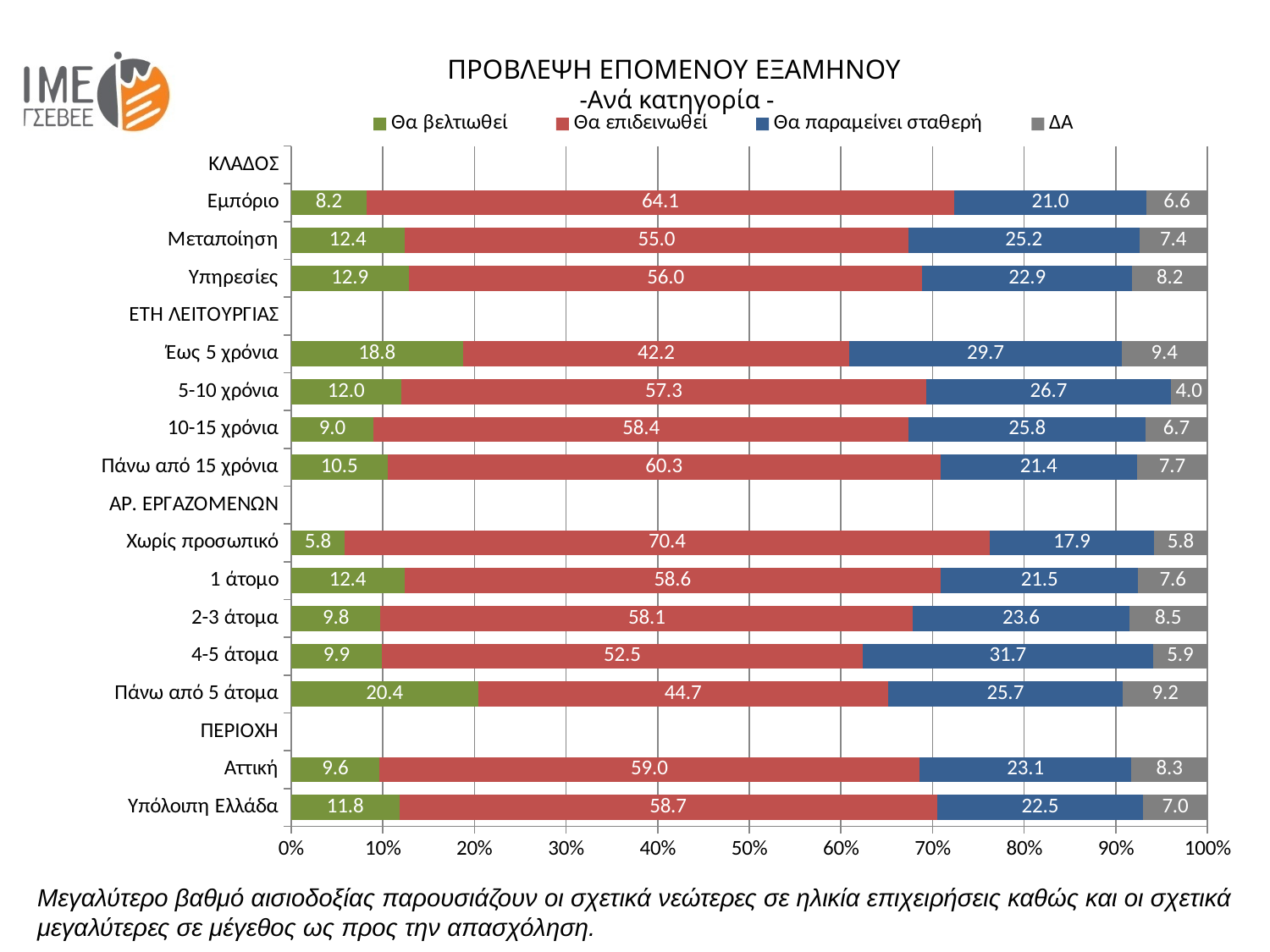
What type of chart is shown on the slide? Stacked bar chart What is the subtitle of the chart? -Ανά κατηγορία - What is the total of the stacked bar for Εμπόριο? 99.9 How many series does the legend list? 4 What is the value of 'Θα παραμείνει σταθερή' for 4-5 άτομα? 31.7 What is the value of 'Θα επιδεινωθεί' for Εμπόριο? 64.1 Which category has the highest 'Θα βελτιωθεί' value? Πάνω από 5 άτομα Which has the larger 'Θα βελτιωθεί' value, Αττική or Υπόλοιπη Ελλάδα? Υπόλοιπη Ελλάδα What is the 'ΔΑ' value for 5-10 χρόνια? 4.0 What is the difference between the 'Θα επιδεινωθεί' values for Εμπόριο and Μεταποίηση? 9.1 Which category has the lowest 'Θα βελτιωθεί' value? Χωρίς προσωπικό Which category has the highest 'Θα επιδεινωθεί' value? Χωρίς προσωπικό